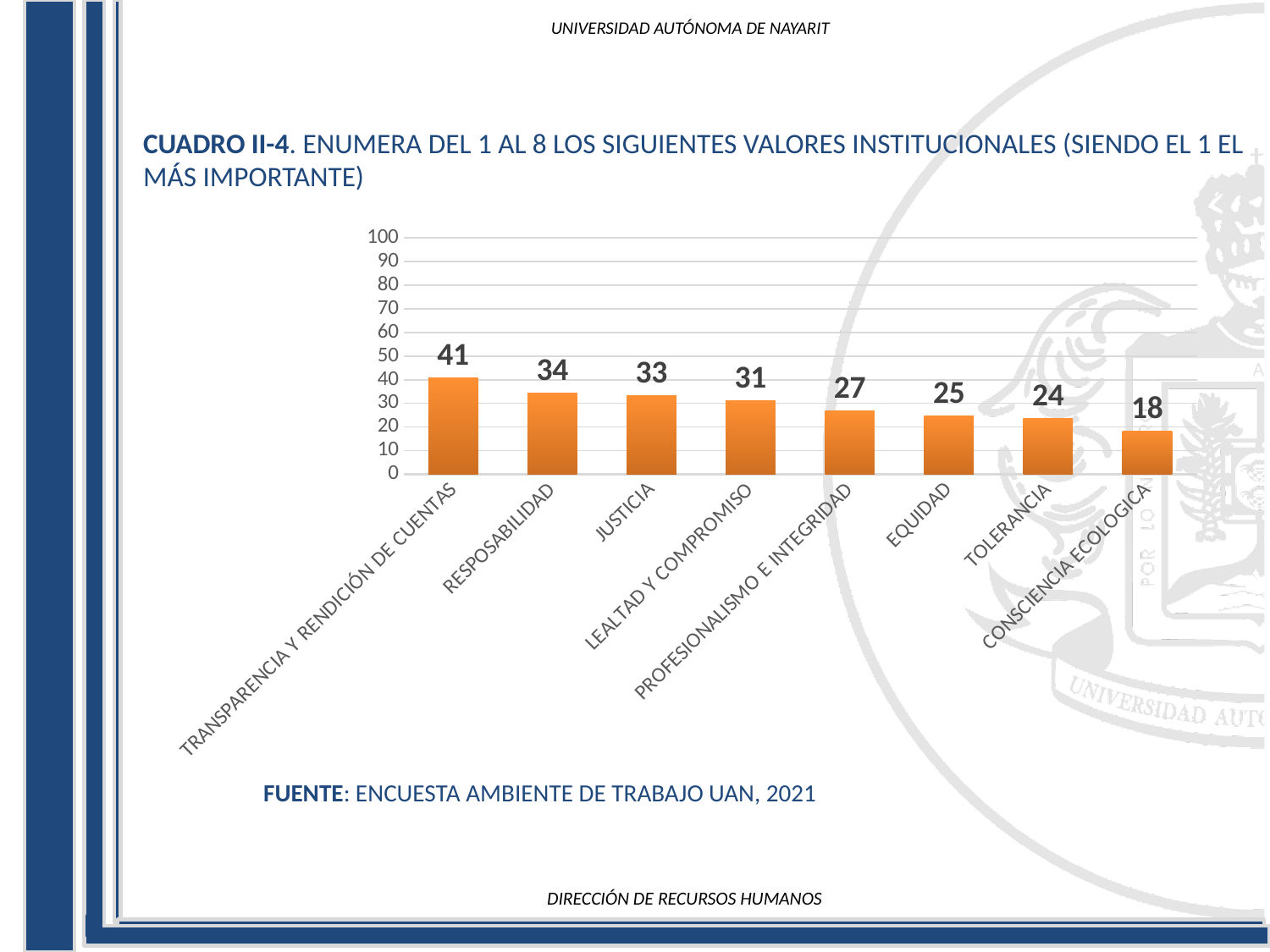
What is the value for TRANSPARENCIA Y RENDICIÓN DE CUENTAS? 41 Which is larger, the value for LEALTAD Y COMPROMISO or the value for PROFESIONALISMO E INTEGRIDAD? LEALTAD Y COMPROMISO Which category has the highest value? TRANSPARENCIA Y RENDICIÓN DE CUENTAS Is the value for RESPOSABILIDAD greater or less than 30? greater What kind of chart is shown on the slide? bar chart Do the values rise or fall from left to right along the x axis? fall Which category has the lowest value? CONSCIENCIA ECOLOGICA What is the value for EQUIDAD? 25 What is the value for JUSTICIA? 33 What is the difference between the values for RESPOSABILIDAD and TOLERANCIA? 10 How many categories are shown in the chart? 8 What is the value for CONSCIENCIA ECOLOGICA? 18